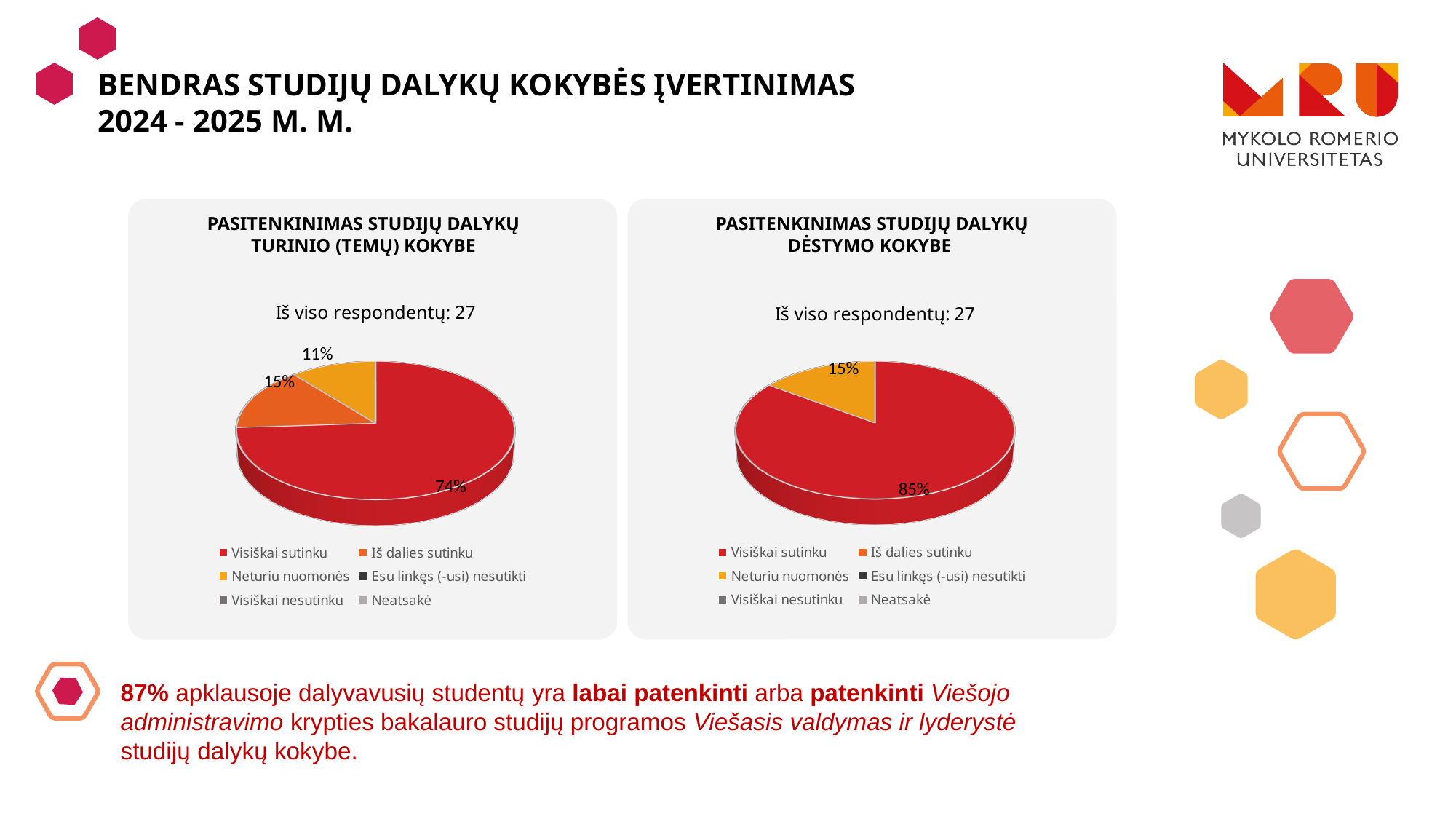
In the left chart, 'Pasitenkinimas studijų dalykų turinio (temų) kokybe', which answer has the smallest slice? Neturiu nuomonės Which chart has the larger 'Visiškai sutinku' share: the left chart on content quality or the right chart on teaching quality? The right chart (Pasitenkinimas studijų dalykų dėstymo kokybe) In the left chart, 'Pasitenkinimas studijų dalykų turinio (temų) kokybe', what share of respondents answered 'Visiškai sutinku'? 74% How many respondents are reported for the left chart, 'Pasitenkinimas studijų dalykų turinio (temų) kokybe'? 27 In the right chart, 'Pasitenkinimas studijų dalykų dėstymo kokybe', what share of respondents answered 'Visiškai sutinku'? 85% What kind of chart is the left chart, 'Pasitenkinimas studijų dalykų turinio (temų) kokybe'? Pie chart In the right chart, 'Pasitenkinimas studijų dalykų dėstymo kokybe', what share of respondents answered 'Neturiu nuomonės'? 15% In the left chart, 'Pasitenkinimas studijų dalykų turinio (temų) kokybe', what share of respondents answered 'Iš dalies sutinku'? 15% How many entries does the legend of the right chart, 'Pasitenkinimas studijų dalykų dėstymo kokybe', list? 6 In the left chart, 'Pasitenkinimas studijų dalykų turinio (temų) kokybe', what share of respondents answered 'Neturiu nuomonės'? 11% In the left chart, 'Pasitenkinimas studijų dalykų turinio (temų) kokybe', what is the difference in percentage points between 'Visiškai sutinku' and 'Iš dalies sutinku'? 59 percentage points In the left chart, 'Pasitenkinimas studijų dalykų turinio (temų) kokybe', which answer has the largest slice? Visiškai sutinku